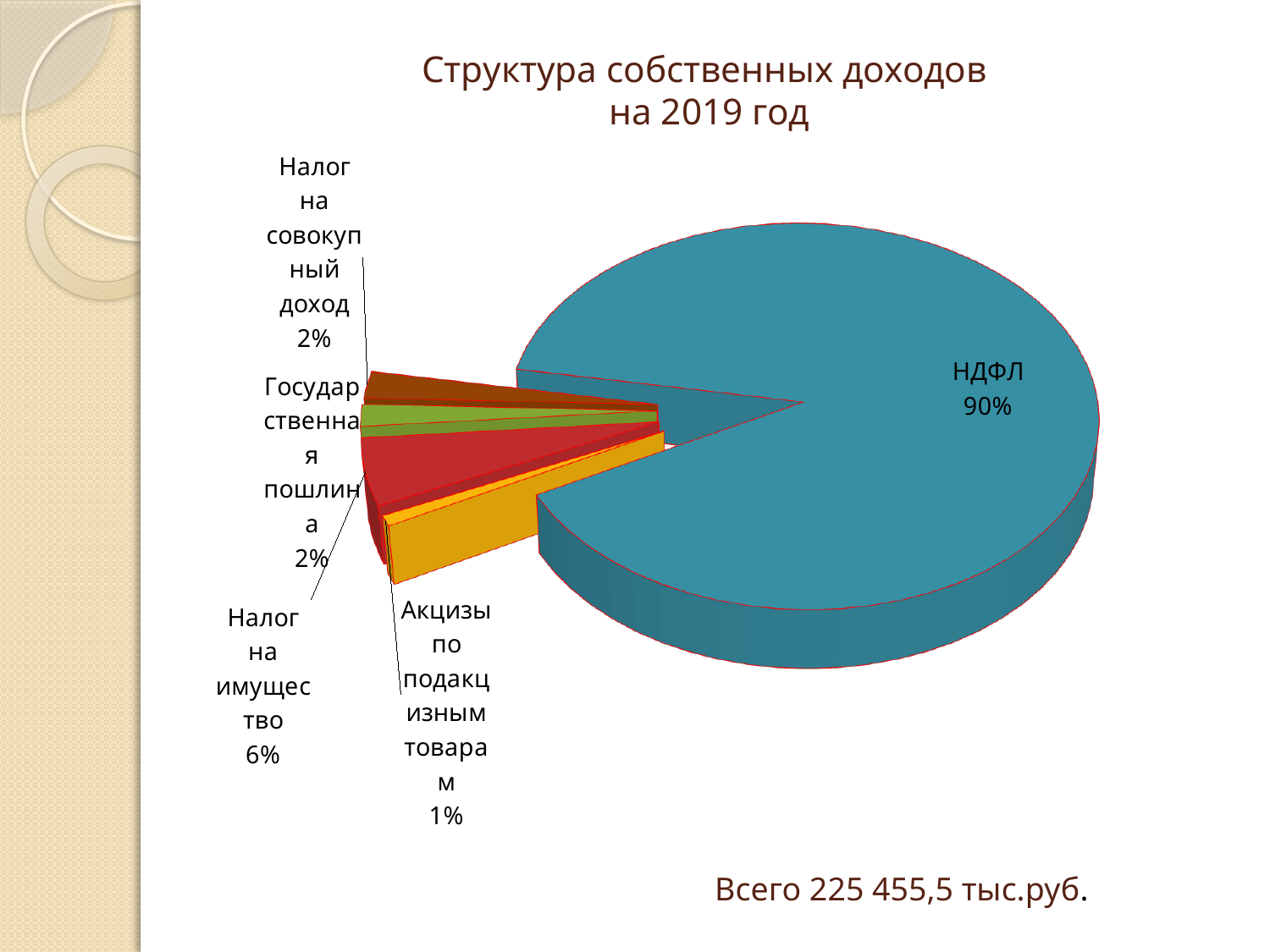
What share of the pie does Акцизы по подакцизным товарам account for? 1% Which is larger: the share of Налог на имущество or the share of Государственная пошлина? Налог на имущество What share of the pie does Налог на совокупный доход account for? 2% What is the difference in percentage points between the share of НДФЛ and the share of Налог на имущество? 84 What share of the pie does Государственная пошлина account for? 2% How many slices does the pie chart have? 5 What kind of chart is shown on the slide? Pie chart Which category has the smallest share of the pie? Акцизы по подакцизным товарам What is the title of the chart? Структура собственных доходов на 2019 год Which category has the largest share of the pie? НДФЛ